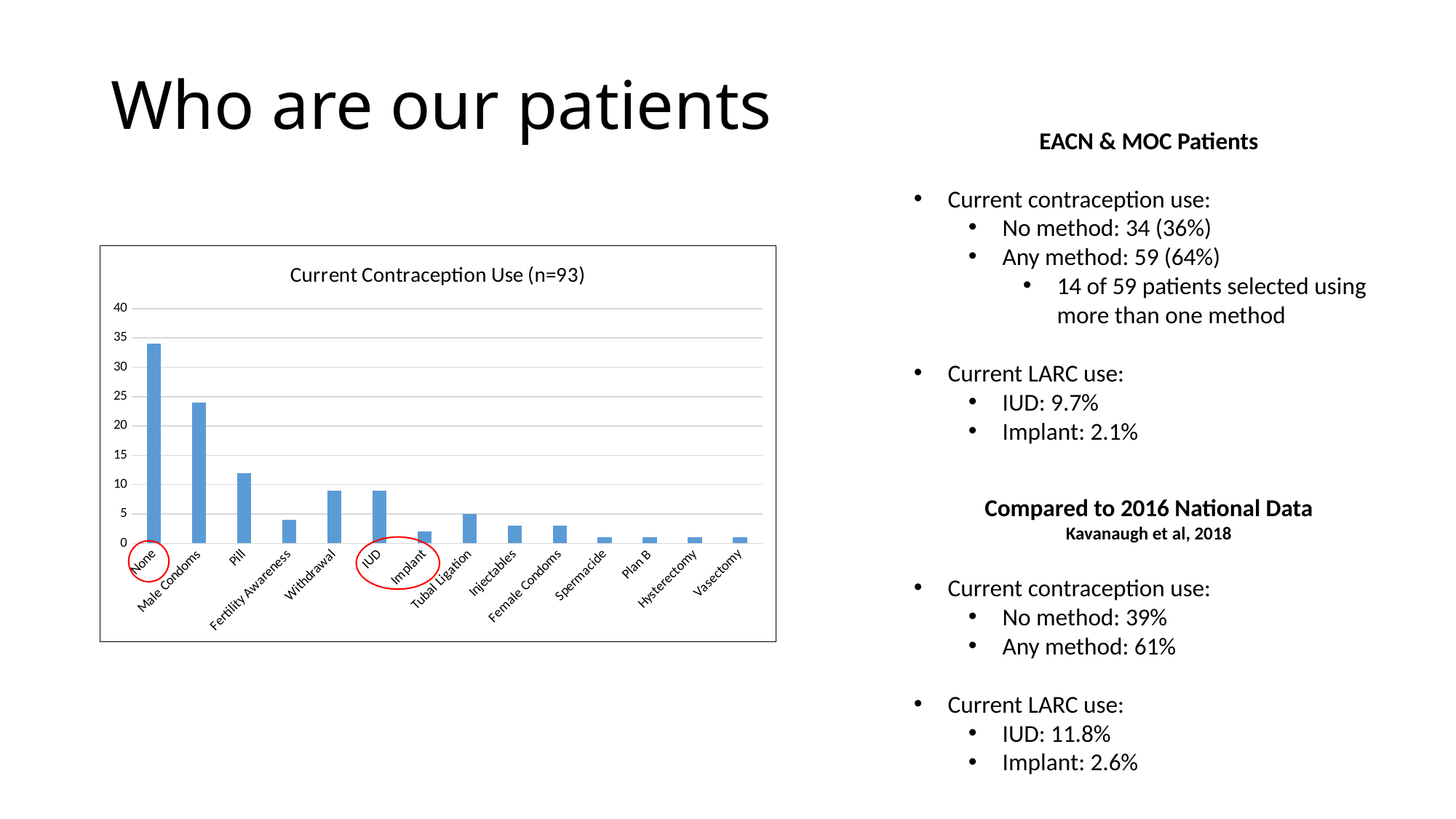
Is the value for Implant greater or less than 5? less What is the title of the chart? Current Contraception Use (n=93) Is the value for Male Condoms greater or less than 20? greater How many contraception categories are shown on the x axis of the chart? 14 Is the value for Pill greater or less than 10? greater Which is larger, the value for Pill or the value for Withdrawal? Pill Which category has the highest bar in the chart? None Which is larger, the value for None or the value for Male Condoms? None What kind of chart is shown on the slide? bar chart Which category labels on the x axis are circled in red? None, IUD, Implant